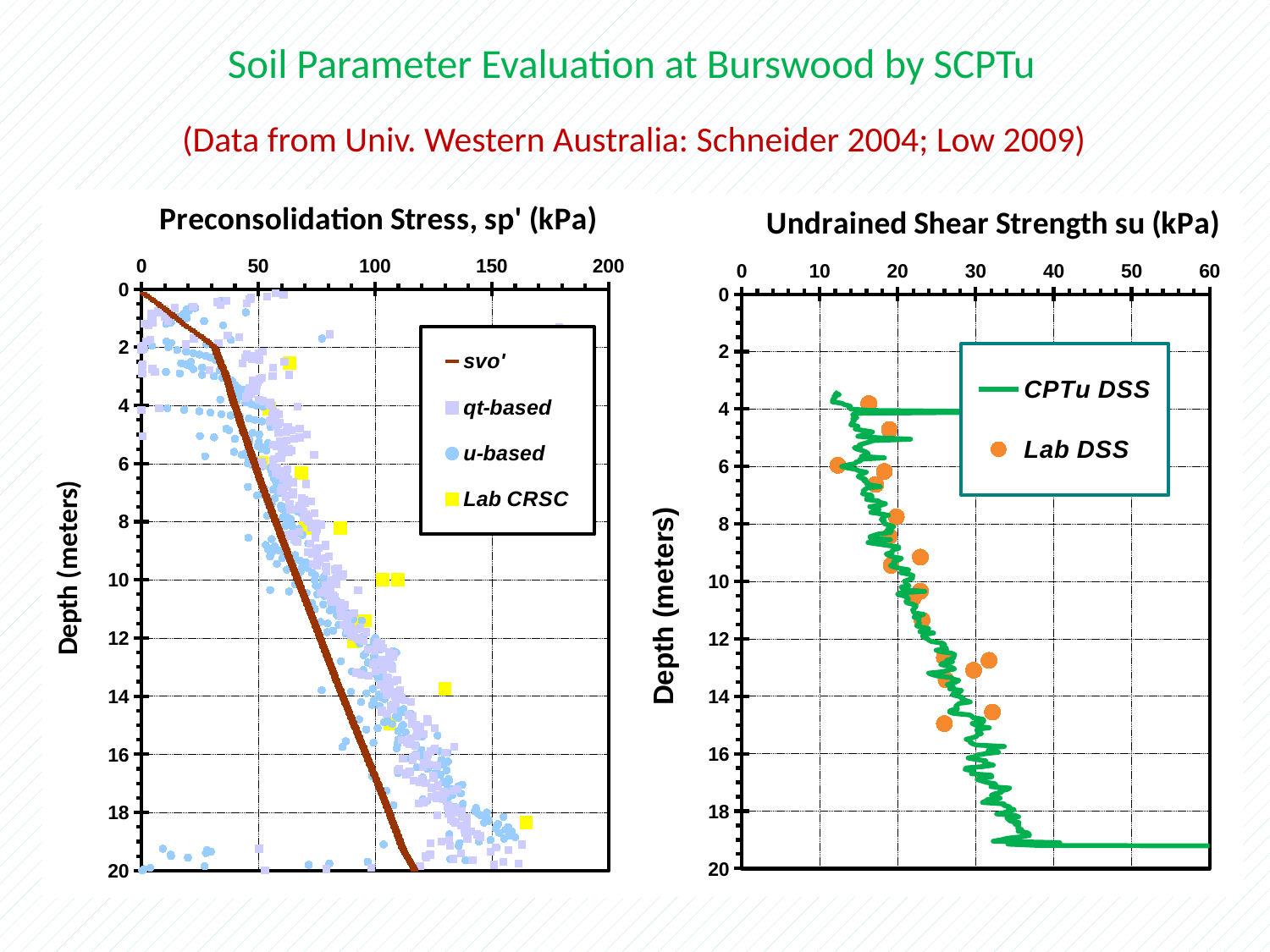
What is the title of the chart on the left? Preconsolidation Stress, sp' (kPa) In the Preconsolidation Stress chart, is the svo' value at a depth of 20 meters greater or less than 100? greater In the Preconsolidation Stress chart, what is the maximum value shown on the horizontal axis? 200 In the Preconsolidation Stress chart, does the svo' line increase or decrease as depth increases? Increase What is the title of the chart on the right? Undrained Shear Strength su (kPa) In the Preconsolidation Stress chart, is the svo' value at a depth of 10 meters greater or less than 50? greater In the Undrained Shear Strength chart, is the CPTu DSS value at a depth of 18 meters greater or less than 30? greater In the Undrained Shear Strength chart, does the CPTu DSS line generally increase or decrease as depth increases from 4 m to 18 m? Increase In the Preconsolidation Stress chart, how many series does the legend list? 4 In the Undrained Shear Strength chart, how many series does the legend list? 2 What kind of chart is the Undrained Shear Strength chart? Scatter chart